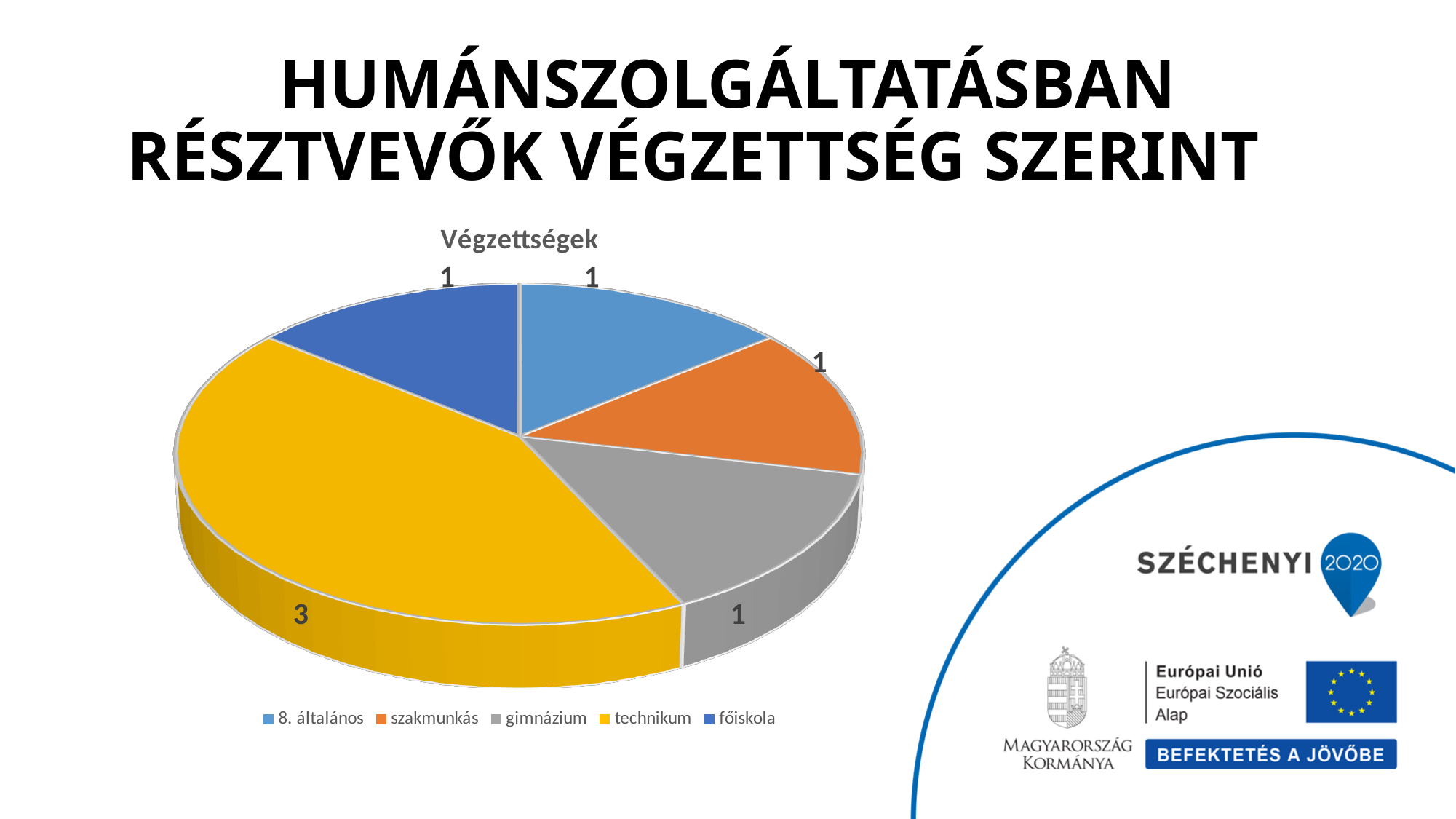
What is the difference between the value for technikum and the value for szakmunkás? 2 How many categories have a value of 1? 4 What colour is the technikum slice? yellow What is the total of all the values in the pie chart? 7 What is the title of the chart? Végzettségek What kind of chart is shown on the slide? pie chart Which category has the largest slice of the pie? technikum How many categories does the legend of the chart list? 5 Which is larger, the value for technikum or the value for 8. általános? technikum What is the value for technikum? 3 What is the value for főiskola? 1 What is the value for gimnázium? 1